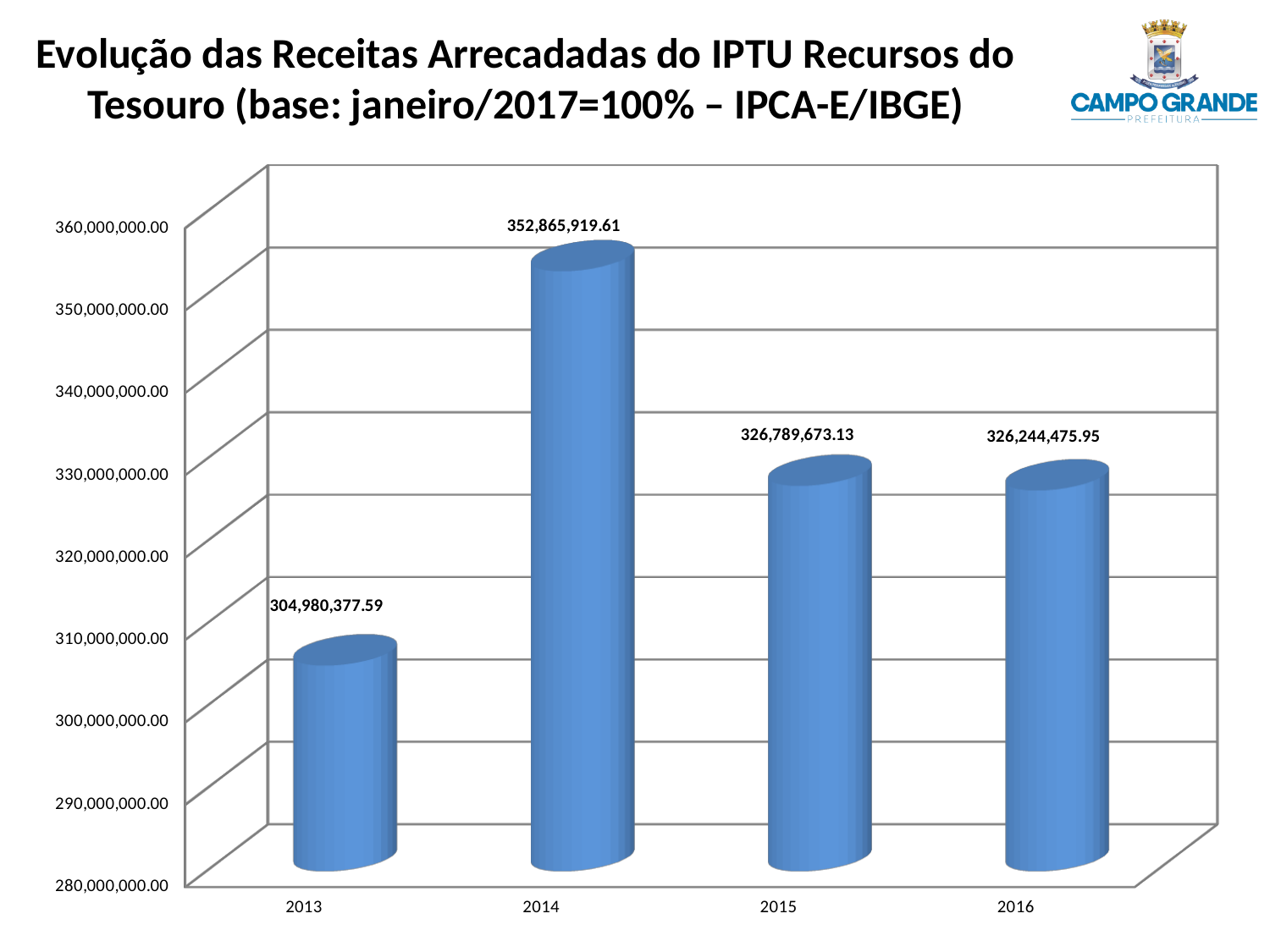
What is the value for 2016? 326,244,475.95 What is the value for 2013? 304,980,377.59 How many years are shown on the x axis? 4 Is the value for 2013 greater or less than 310,000,000.00? less What is the difference between the values for 2014 and 2013? 47,885,542.02 What is the difference between the values for 2015 and 2016? 545,197.18 What is the value for 2014? 352,865,919.61 Which is larger, the value for 2015 or the value for 2016? 2015 Which year has the lowest value? 2013 Does the value rise or fall from 2014 to 2015? fall Which year has the highest value? 2014 What kind of chart is this? bar chart